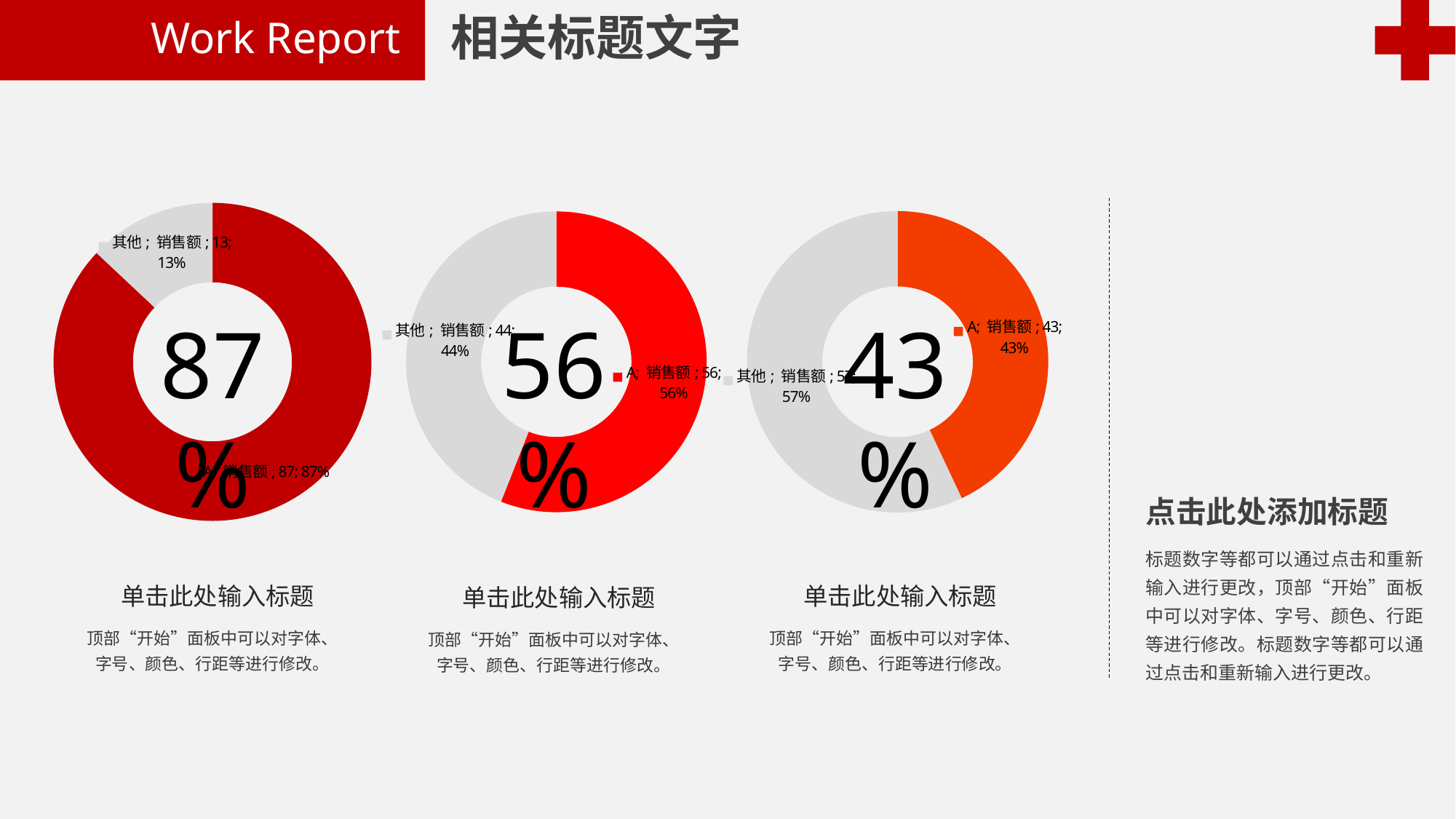
In the middle doughnut chart, what is the difference between the values for A and 其他? 12 In the left doughnut chart, what value is shown for category A? 87 In the left doughnut chart, what percentage share does 其他 have? 13% In the right doughnut chart, what value is shown for category A? 43 What type of chart is the middle chart on the slide? Doughnut chart How many categories does the left doughnut chart contain? 2 In the middle doughnut chart, what percentage share does category A have? 56% How many doughnut charts are shown on the slide? 3 In the right doughnut chart, which category has the larger value, A or 其他? 其他 In the left doughnut chart, what is the difference between the values for A and 其他? 74 In the right doughnut chart, what percentage share does 其他 have? 57% In the middle doughnut chart, what value is shown for 其他? 44